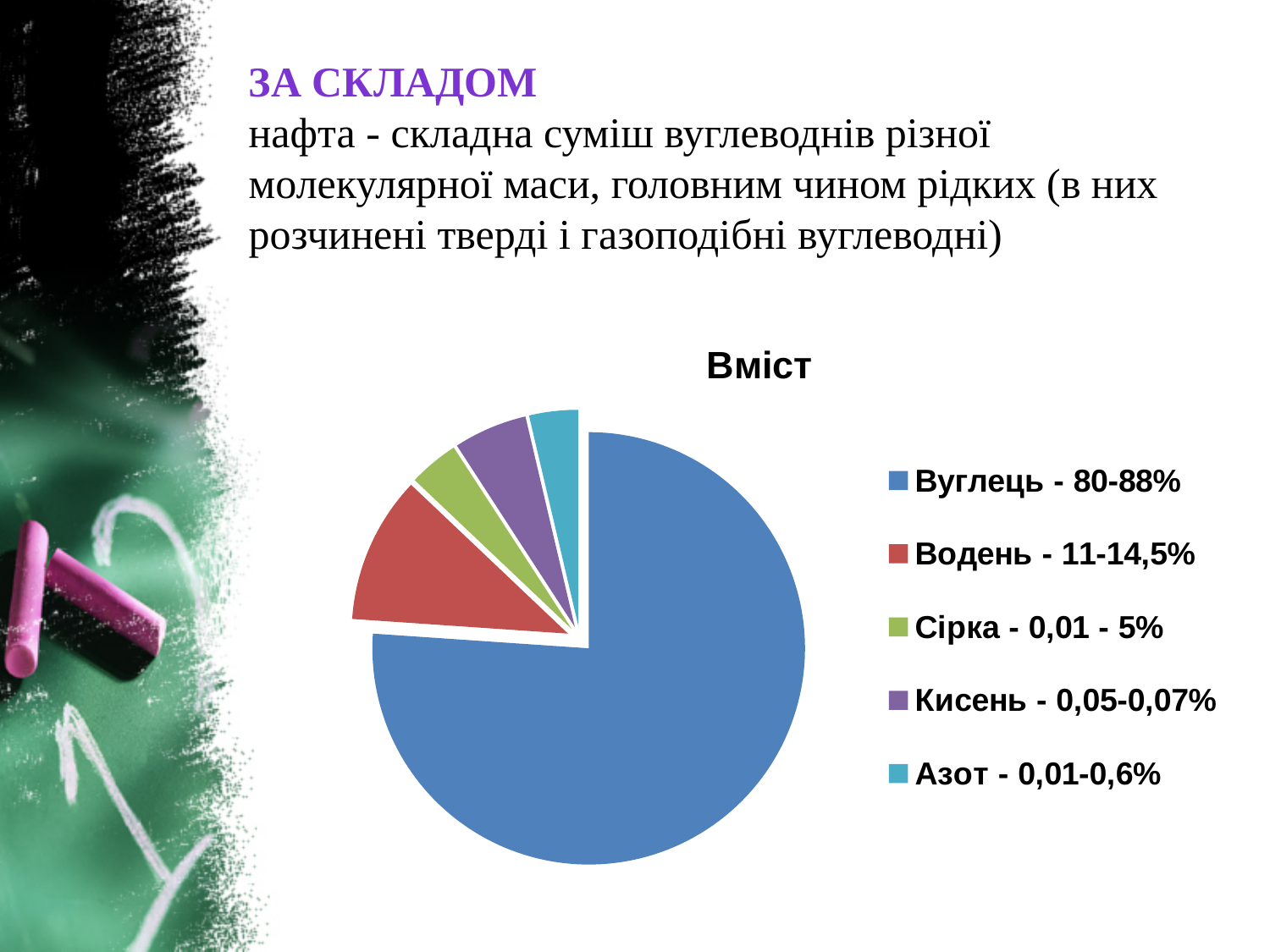
How many slices does the pie chart have? 5 According to the legend, what content range is given for Азот? 0,01-0,6% Which category has the largest slice of the pie? Вуглець What type of chart is shown on the slide? pie chart Which slice is larger, Водень or Сірка? Водень What colour is the slice for Вуглець? blue What is the title of the chart? Вміст According to the legend, what content range is given for Кисень? 0,05-0,07% According to the legend, what content range is given for Вуглець? 80-88% How many entries does the chart legend list? 5 According to the legend, what content range is given for Водень? 11-14,5% Which slice is larger, Вуглець or Водень? Вуглець